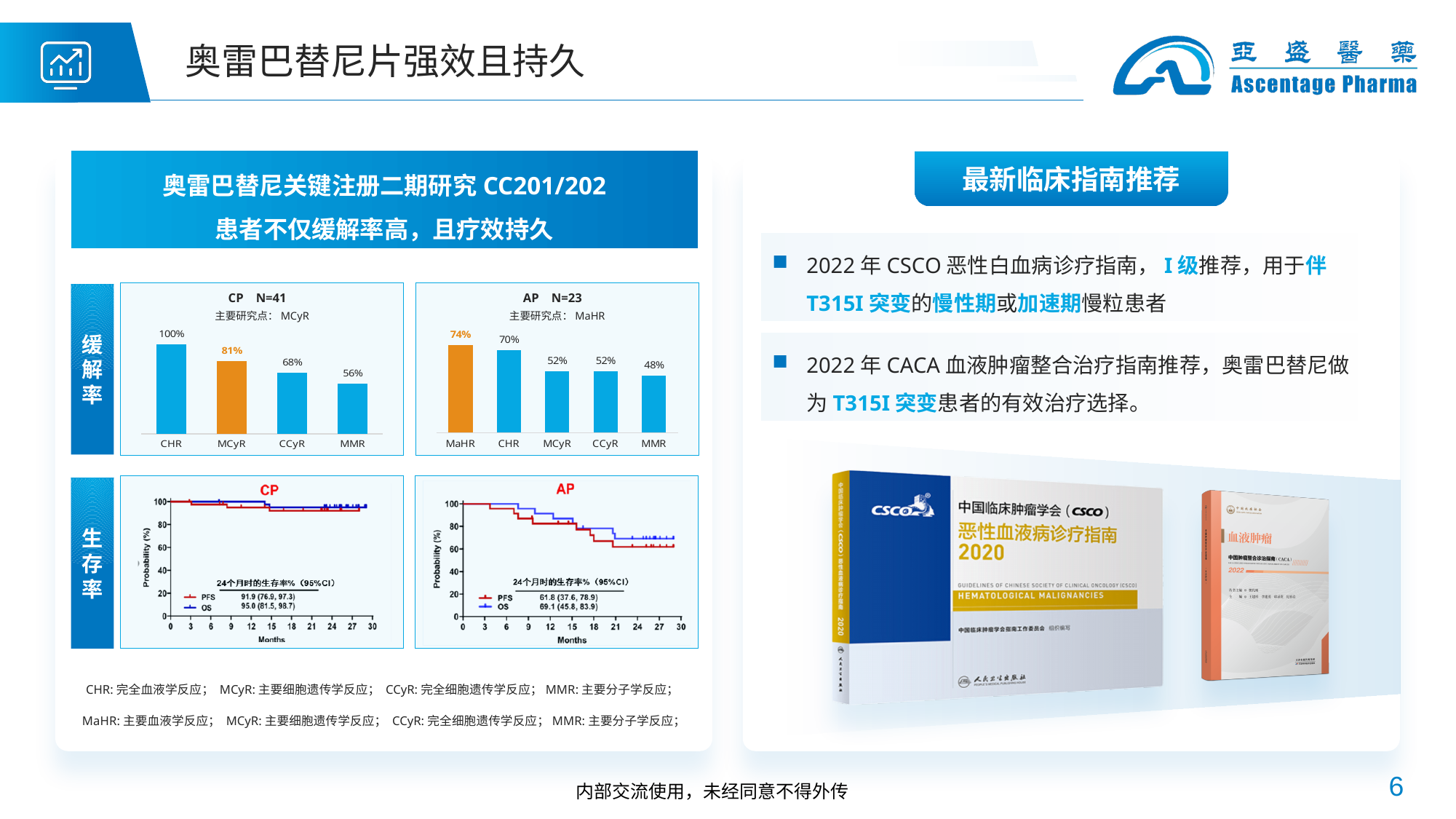
In the AP N=23 bar chart, how many categories are shown? 5 In the AP survival chart, what is the 24-month OS rate shown? 69.1 (45.8, 83.9) In the CP N=41 bar chart, what is the value for MCyR? 81% In the CP survival chart, what is the 24-month PFS rate shown? 91.9 (76.9, 97.3) In the AP N=23 bar chart, what is the value for MaHR? 74% What kind of chart is the CP N=41 chart? Bar chart In the AP N=23 bar chart, what is the difference between the MaHR and CHR values? 4% Which is larger: the MCyR value in the CP N=41 chart or the MCyR value in the AP N=23 chart? CP N=41 In the CP N=41 bar chart, which category has the lowest value? MMR In the CP N=41 bar chart, what is the difference between the CHR and MMR values? 44% In the AP N=23 bar chart, which category has the lowest value? MMR In the CP N=41 bar chart, which category has the highest value? CHR